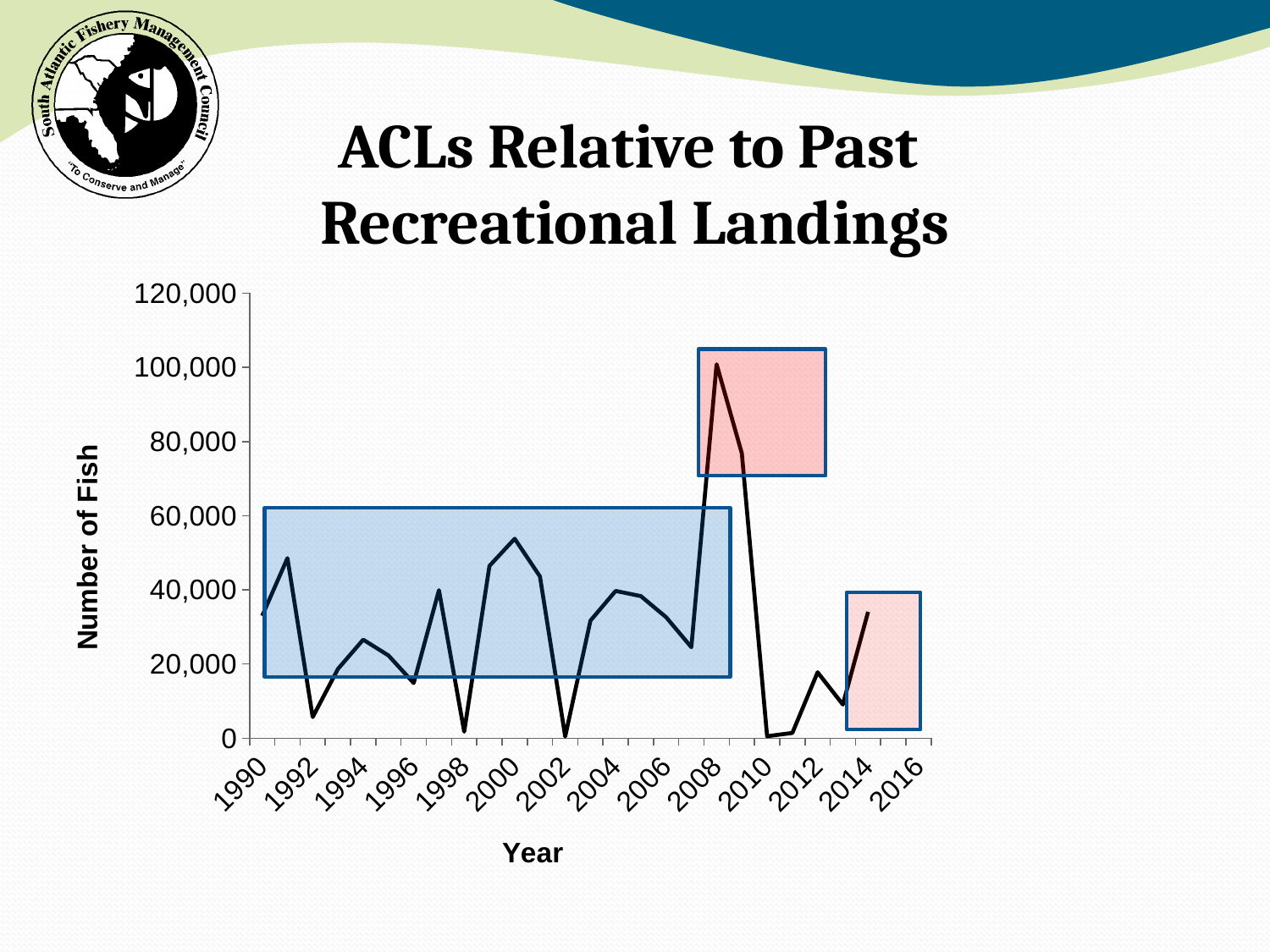
What is the label of the vertical axis of the chart? Number of Fish Is the value for 2010 greater or less than 20,000? less How many year labels are shown along the x axis? 14 Is the value for 2000 greater or less than 40,000? greater Is the value for 2009 greater or less than 80,000? less What is the title of the chart on the slide? ACLs Relative to Past Recreational Landings Which year has the larger value, 2009 or 2000? 2009 Does the line rise or fall between 2009 and 2010? fall What kind of chart is shown on the slide? line chart In which year does the line reach its highest value? 2008